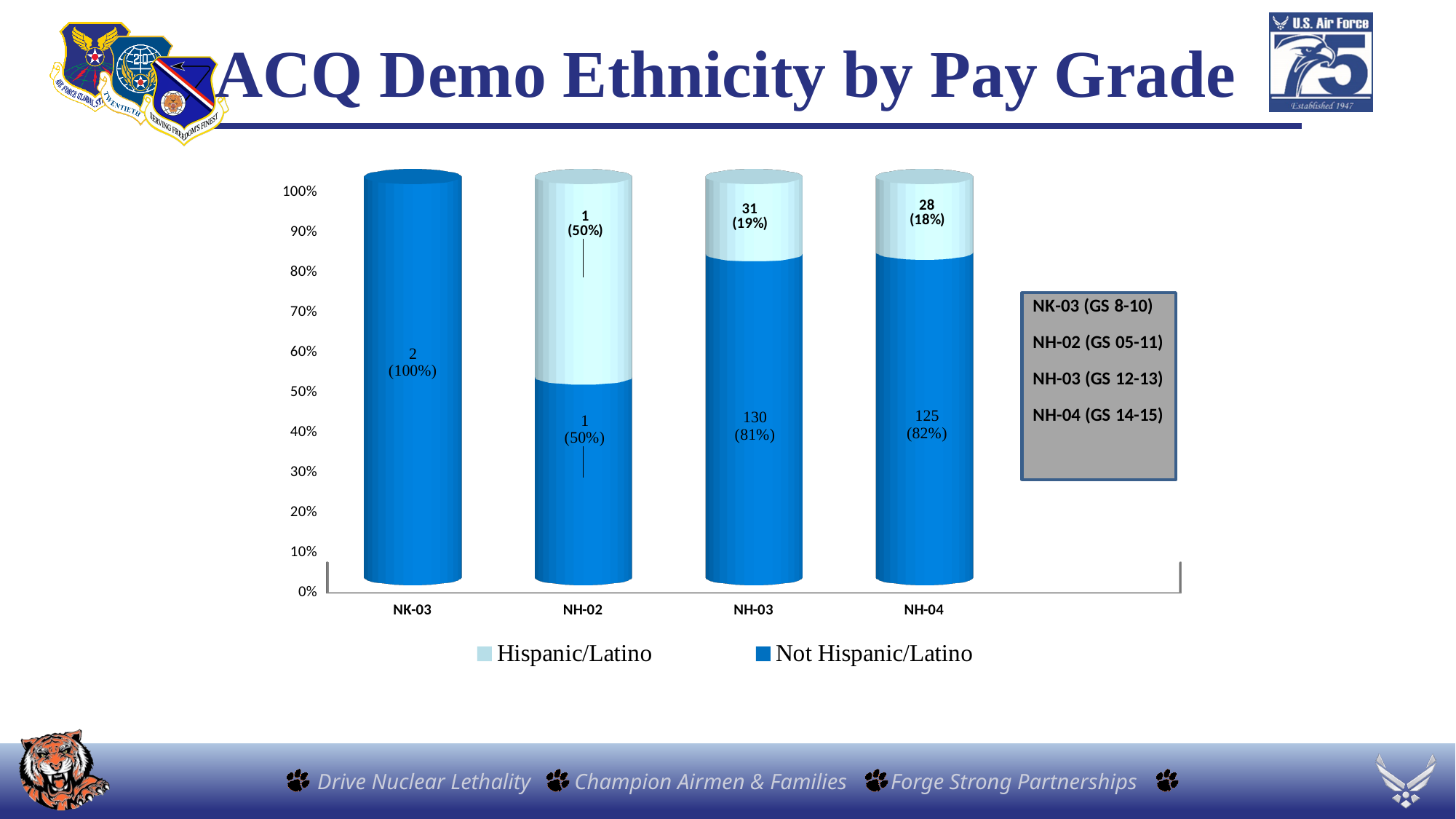
What is the Hispanic/Latino count for NH-04? 28 Which pay grade has the highest Not Hispanic/Latino count? NH-03 How many pay grade categories are shown on the x axis? 4 Which pay grade has the lowest Hispanic/Latino count? NK-03 What is the total count for NH-03 across both series? 161 What kind of chart is shown on the slide? Stacked bar chart How many series does the legend list? 2 What percentage of NH-04 is Not Hispanic/Latino? 82% Which series is shown in the darker blue colour? Not Hispanic/Latino What is the difference between the Not Hispanic/Latino counts for NH-03 and NH-04? 5 What percentage of NH-02 is Hispanic/Latino? 50% What is the Not Hispanic/Latino count for NH-03? 130